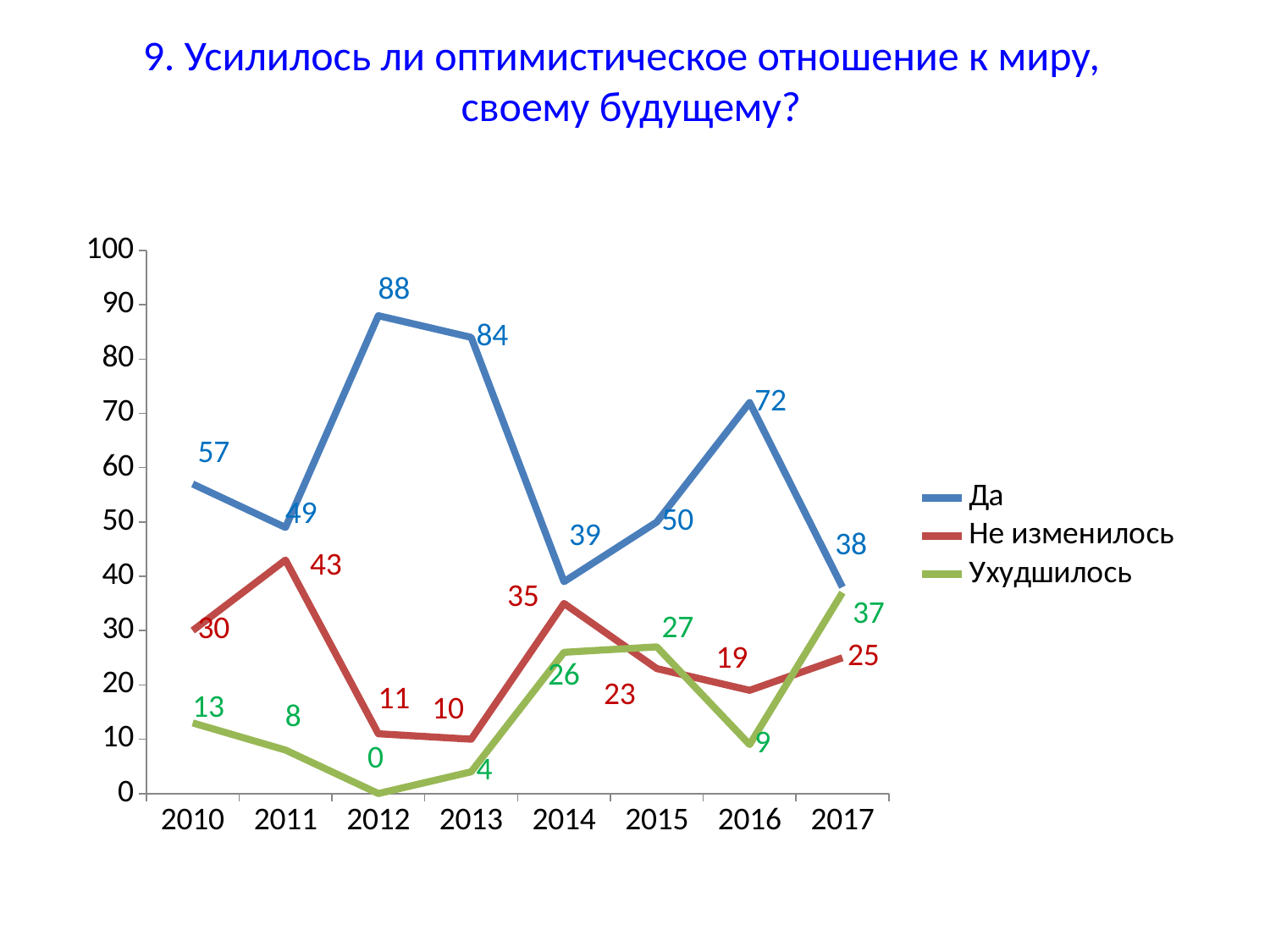
Does the "Да" series rise or fall from 2013 to 2014? Fall What is the value of the "Не изменилось" series in 2011? 43 How many years are shown on the x axis? 8 In which year does the "Ухудшилось" series have its lowest value? 2012 What kind of chart is shown on the slide? Line chart What colour is the line for the "Не изменилось" series? Red In which year does the "Да" series reach its highest value? 2012 What is the value of the "Да" series in 2012? 88 How many series does the legend list? 3 Which is larger in 2015: the "Не изменилось" value or the "Ухудшилось" value? Ухудшилось What is the difference between the "Да" values in 2012 and 2017? 50 What is the value of the "Ухудшилось" series in 2017? 37